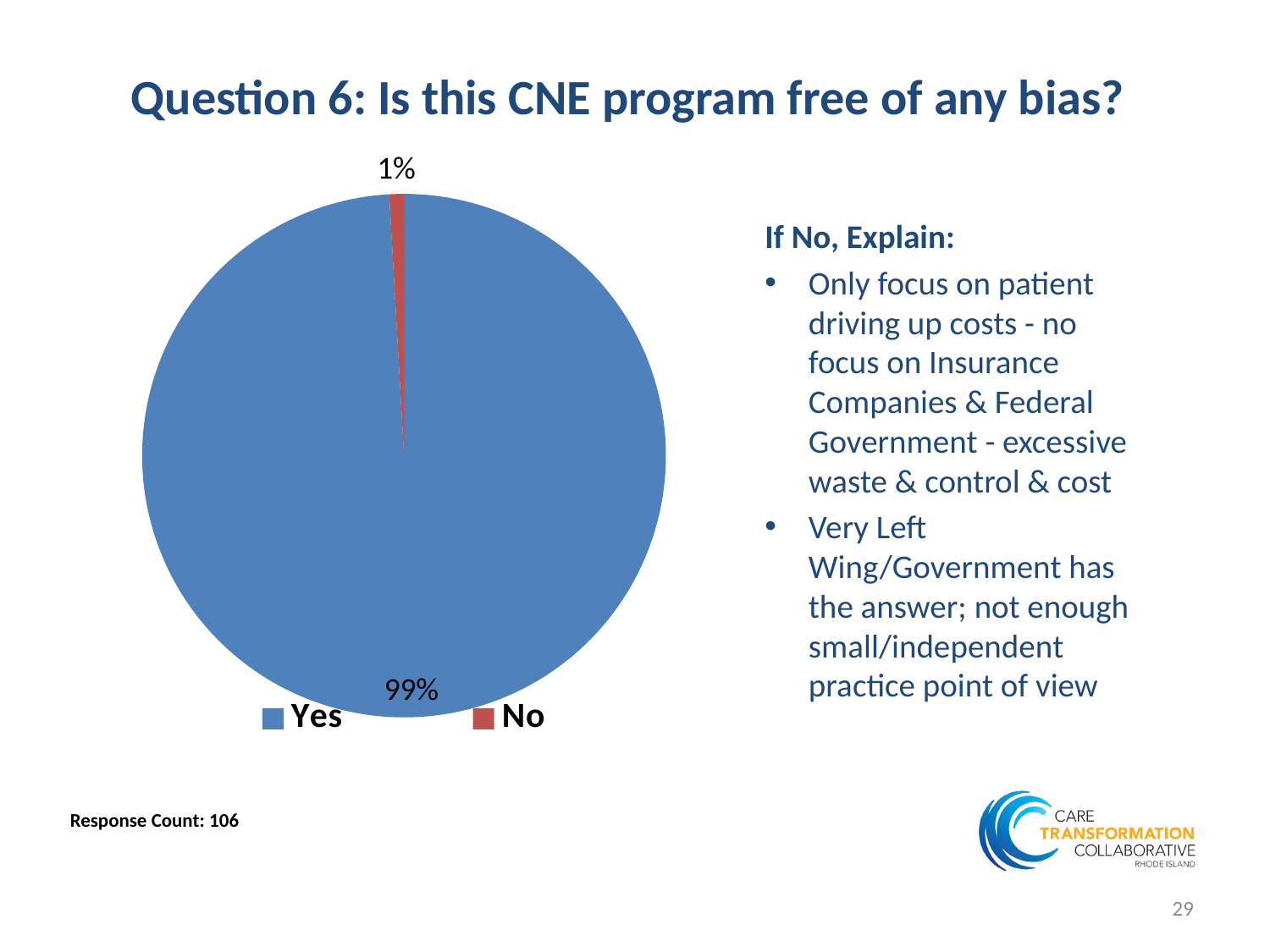
What colour is the Yes slice in the pie chart? blue What share of the pie does the No slice represent? 1% Which slice of the pie is the smallest? No Which is larger, the Yes slice or the No slice? Yes What kind of chart is shown on the slide? pie chart What share of the pie does the Yes slice represent? 99% How many entries does the legend list? 2 What is the response count shown on the slide? 106 How many slices does the pie chart have? 2 What is the difference in percentage points between the Yes and No slices? 98 Which slice of the pie is the largest? Yes